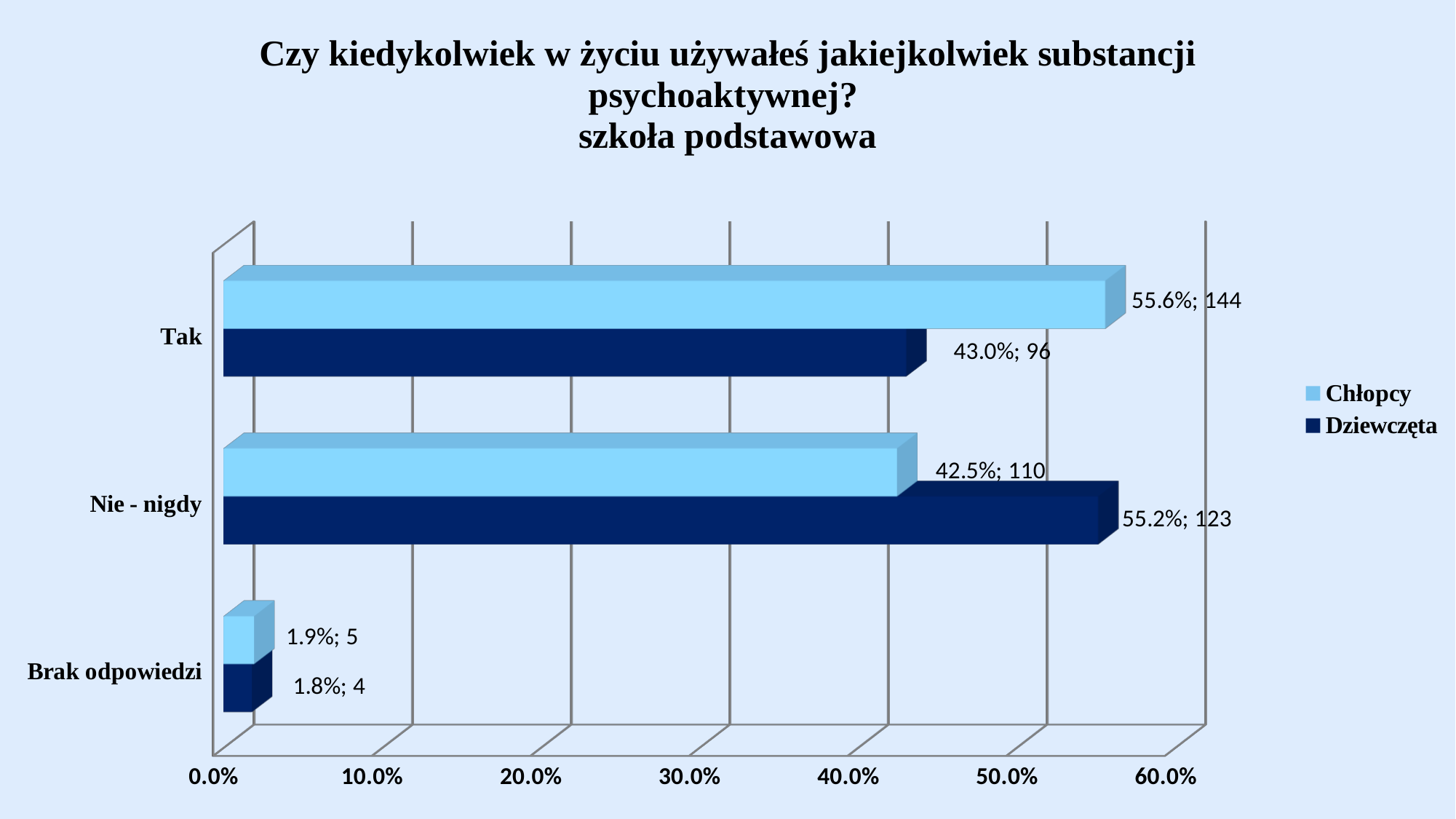
What is the difference in percentage points between Chłopcy and Dziewczęta for Tak? 12.6 How many response categories are shown on the chart? 3 Which category has the lowest value for Dziewczęta? Brak odpowiedzi What percentage of Dziewczęta answered Nie - nigdy? 55.2% How many series does the legend list? 2 How many Dziewczęta answered Tak? 96 Which series is shown in dark blue? Dziewczęta What percentage of Chłopcy gave Brak odpowiedzi? 1.9% Which category has the highest value for Chłopcy? Tak What percentage of Chłopcy answered Tak? 55.6% What kind of chart is shown on the slide? Bar chart Which is larger for Nie - nigdy: Chłopcy or Dziewczęta? Dziewczęta